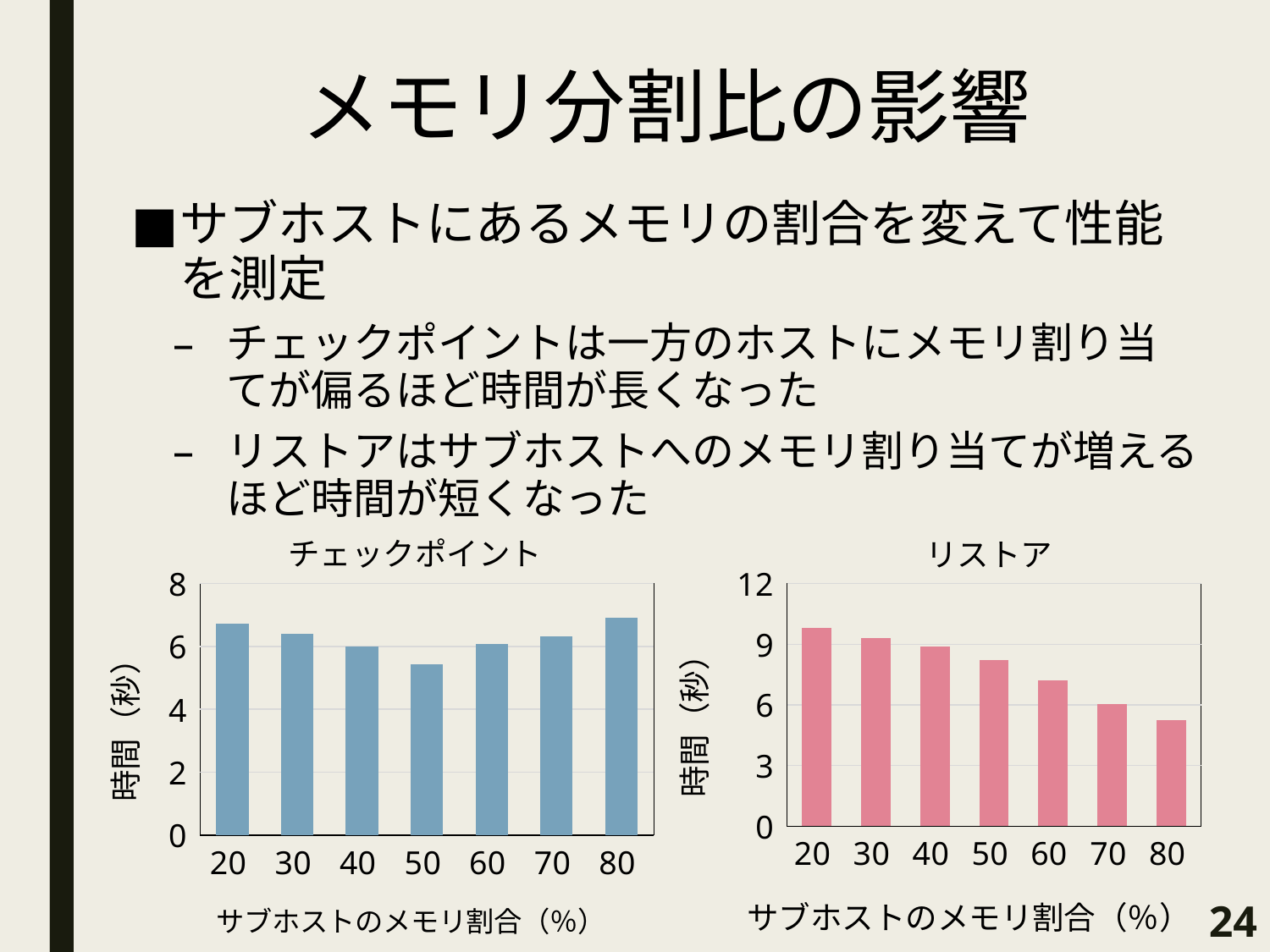
In the リストア chart, do the values rise or fall as the memory ratio increases from 20 to 80? fall In the チェックポイント chart, which is larger, the value for 50 or the value for 80? 80 In the リストア chart, which memory ratio has the highest time? 20 In the リストア chart, which memory ratio has the lowest time? 80 In the リストア chart, is the value for 20 greater or less than 9? greater How many memory ratio categories are shown in the チェックポイント chart? 7 What kind of chart is the リストア chart? bar chart In the リストア chart, is the value for 80 greater or less than 6? less In the リストア chart, which is larger, the value for 20 or the value for 80? 20 In the チェックポイント chart, which memory ratio has the lowest time? 50 In the チェックポイント chart, is the value for 50 greater or less than 6? less